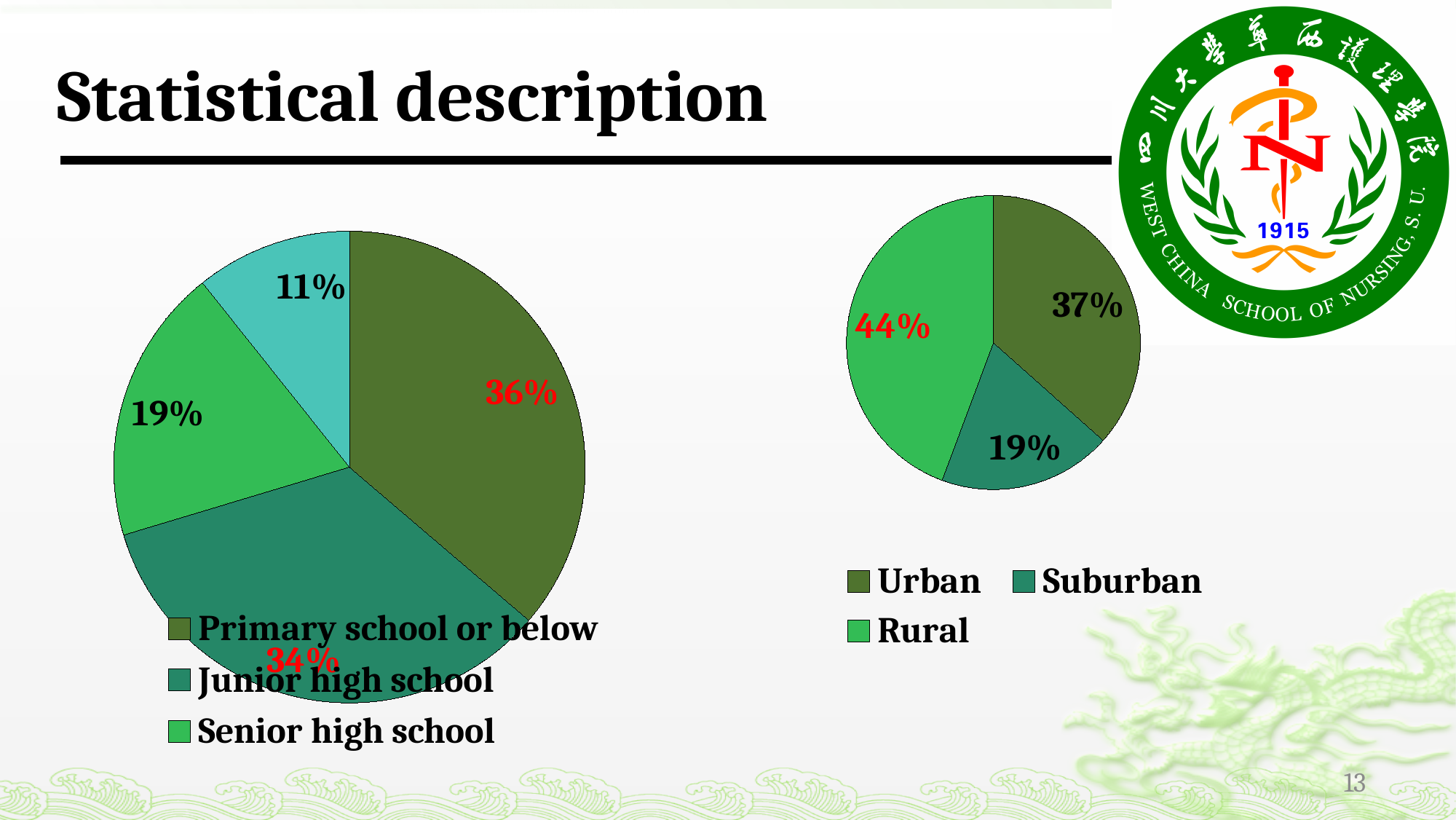
In the left pie chart, what share is labelled for Junior high school? 34% How many categories does the legend of the right pie chart list? 3 What type of chart is the left chart on the slide? pie chart In the right pie chart, what is the difference in percentage points between Rural and Urban? 7 In the right pie chart, which category has the smallest slice? Suburban In the left pie chart, what share is labelled for Senior high school? 19% In the right pie chart, what share is labelled for Rural? 44% In the right pie chart, which category has the largest slice? Rural In the right pie chart, what share is labelled for Urban? 37% In the left pie chart, which is larger: Primary school or below or Junior high school? Primary school or below In the left pie chart, what share is labelled for Primary school or below? 36% In the left pie chart, which category has the largest slice? Primary school or below